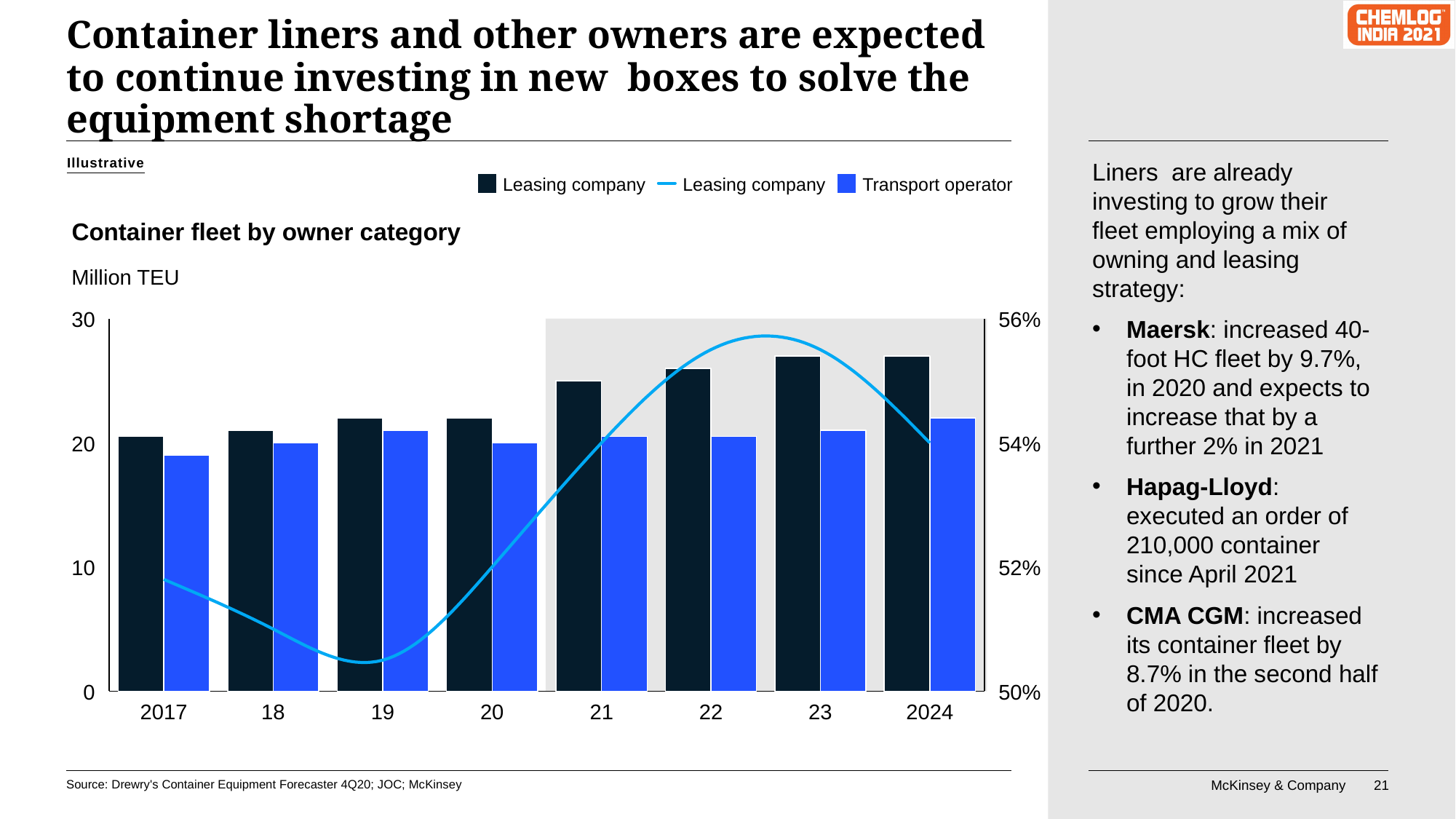
Is the Leasing company bar for 2023 greater or less than 20 million TEU? greater What is the title of the chart? Container fleet by owner category What unit is the left axis of the chart measured in? Million TEU What kind of chart is shown on the slide? Bar chart with a line How many years are shown on the x axis of the chart? 8 In which year is the Transport operator bar the lowest? 2017 Is the Transport operator bar for 2017 greater or less than 20 million TEU? less In 2023, which is larger: the Leasing company bar or the Transport operator bar? Leasing company Is the Leasing company bar for 2021 greater or less than 20 million TEU? greater How many series does the legend list? 3 Do the Leasing company bars generally rise or fall from 2017 to 2024? rise